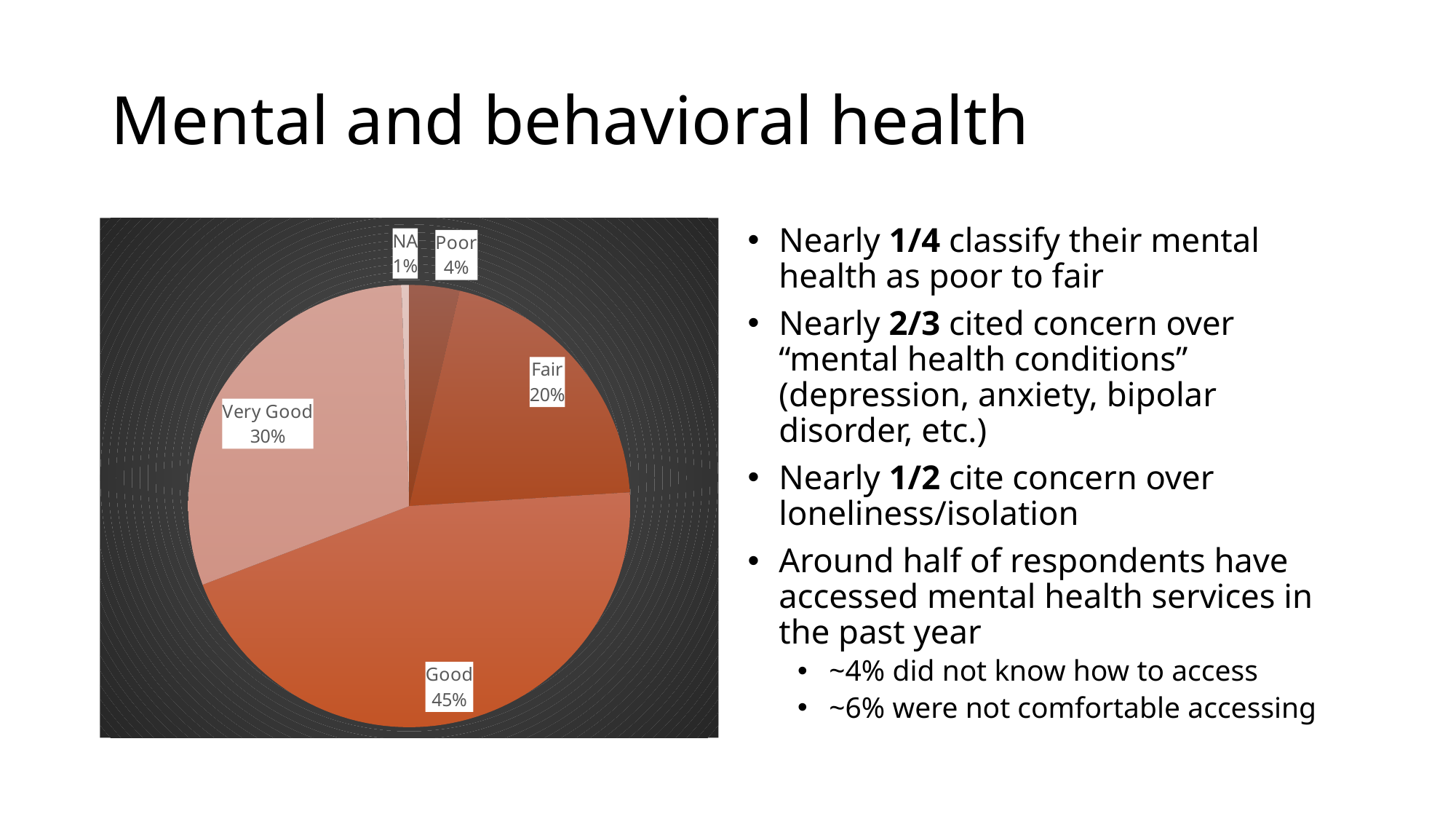
Which category has the smallest slice of the pie? NA How many slices does the pie chart have? 5 Which category has the largest slice of the pie? Good What share of the pie is labelled Fair? 20% What share of the pie is labelled Very Good? 30% What is the combined share of the Poor and Fair slices? 24% What share of the pie is labelled NA? 1% What is the difference in percentage points between the Good and Very Good slices? 15% What share of the pie is labelled Good? 45% What kind of chart is shown on the slide? Pie chart Which slice is larger, Fair or Poor? Fair What share of the pie is labelled Poor? 4%